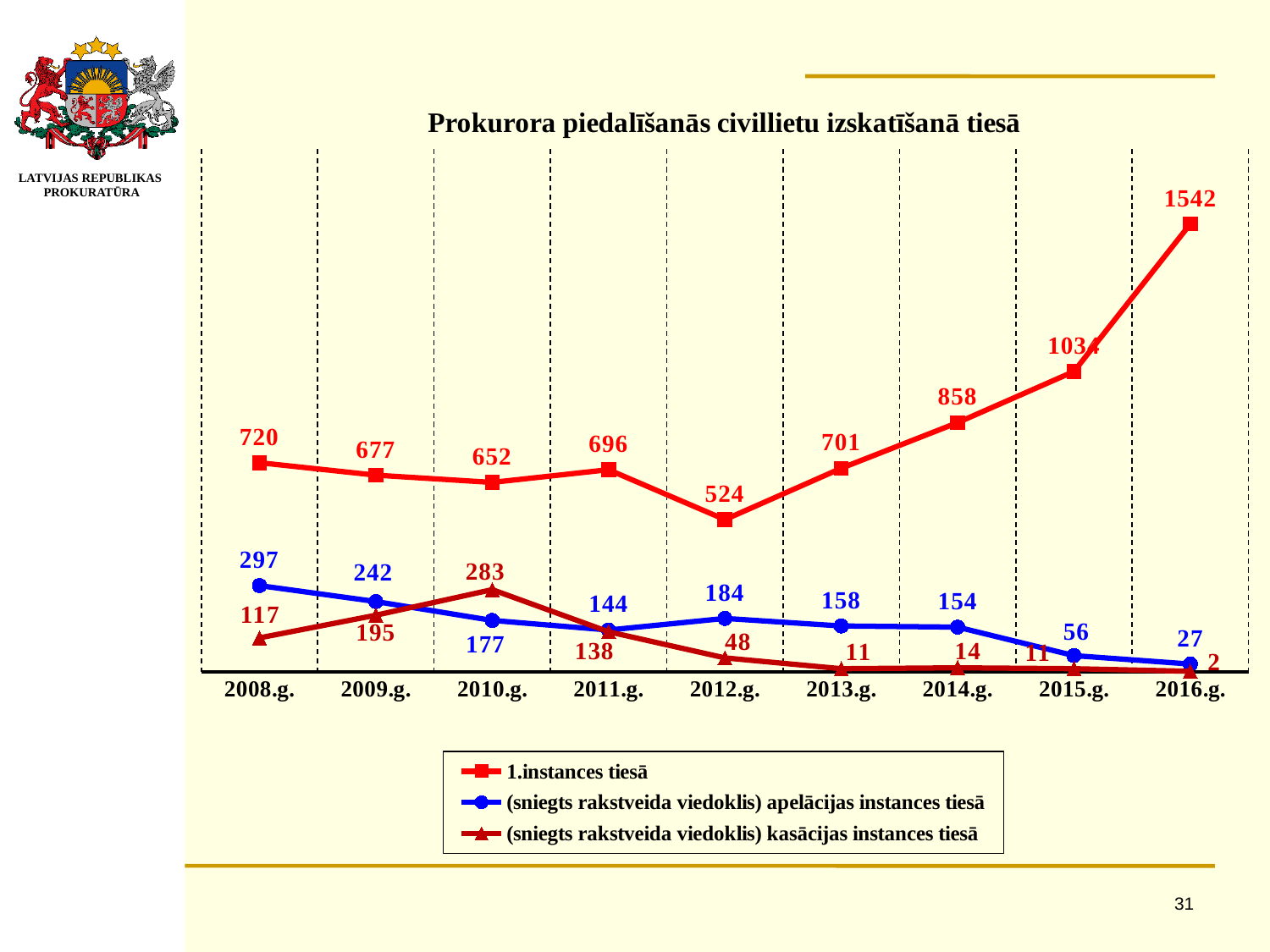
What is the value for (sniegts rakstveida viedoklis) kasācijas instances tiesā in 2010.g.? 283 How many years are shown on the x axis? 9 What is the value for (sniegts rakstveida viedoklis) apelācijas instances tiesā in 2008.g.? 297 In which year is the value for 1.instances tiesā lowest? 2012.g. What is the value for 1.instances tiesā in 2016.g.? 1542 How many series does the legend list? 3 In which year is the value for (sniegts rakstveida viedoklis) kasācijas instances tiesā highest? 2010.g. Does the value for (sniegts rakstveida viedoklis) apelācijas instances tiesā rise or fall from 2013.g. to 2016.g.? fall Which is larger in 2010.g.: the apelācijas instances tiesā value or the kasācijas instances tiesā value? kasācijas instances tiesā What is the value for 1.instances tiesā in 2012.g.? 524 What kind of chart is shown on the slide? line chart What is the difference between the 1.instances tiesā values for 2016.g. and 2014.g.? 684